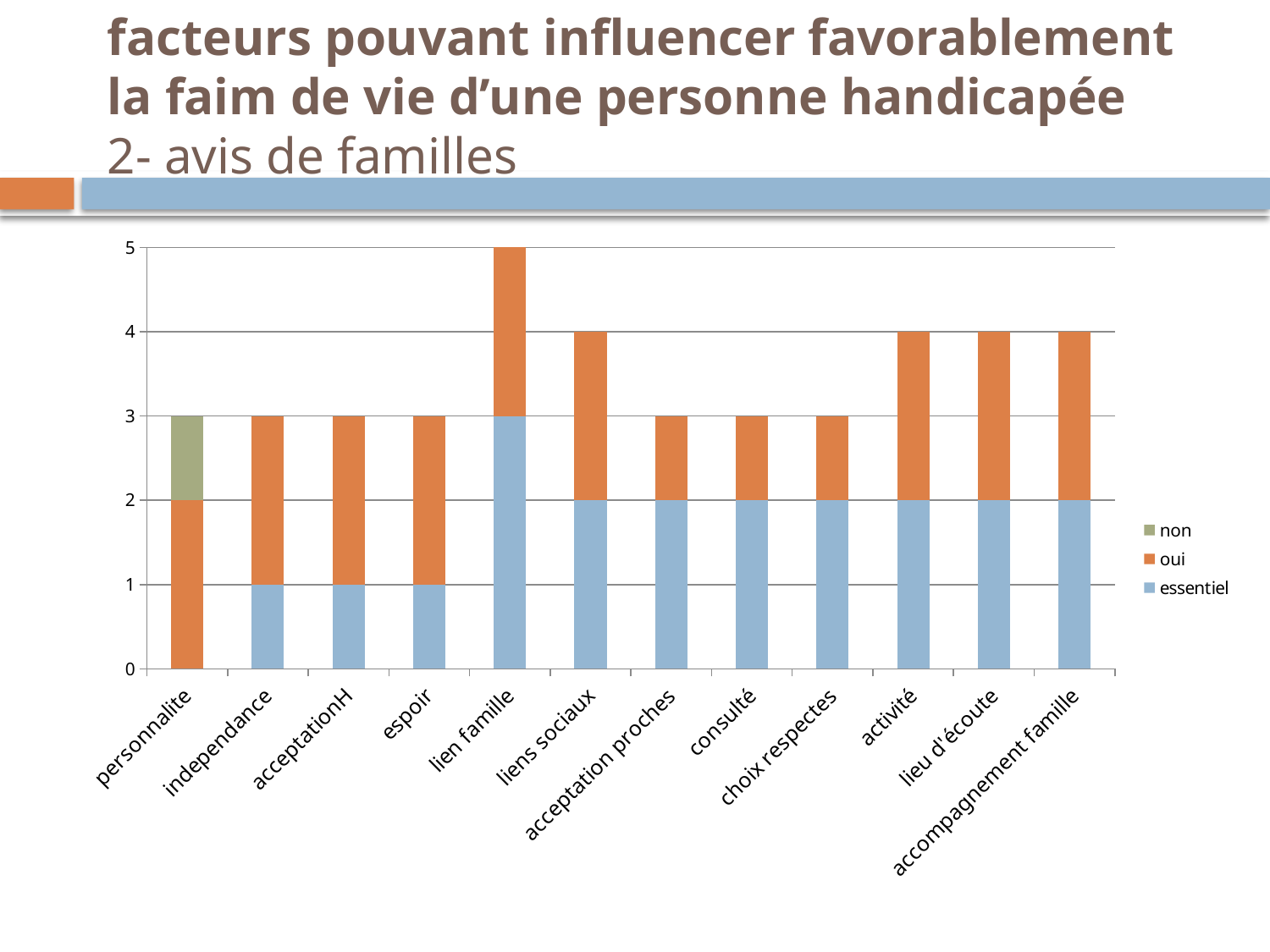
What kind of chart is shown on the slide? stacked bar chart Which category has the highest total bar? lien famille How many categories are shown on the x axis? 12 Is the total bar for activité larger or smaller than the total bar for consulté? larger What is the difference between the total bar for lien famille and the total bar for espoir? 2 How many series does the legend list? 3 Which category is the only one with a non-zero value for the non series? personnalite What is the value of the essentiel series for lien famille? 3 What is the value of the oui series for personnalite? 2 What are the three legend entries? non, oui, essentiel What is the value of the essentiel series for independance? 1 What is the total height of the stacked bar for lien famille? 5